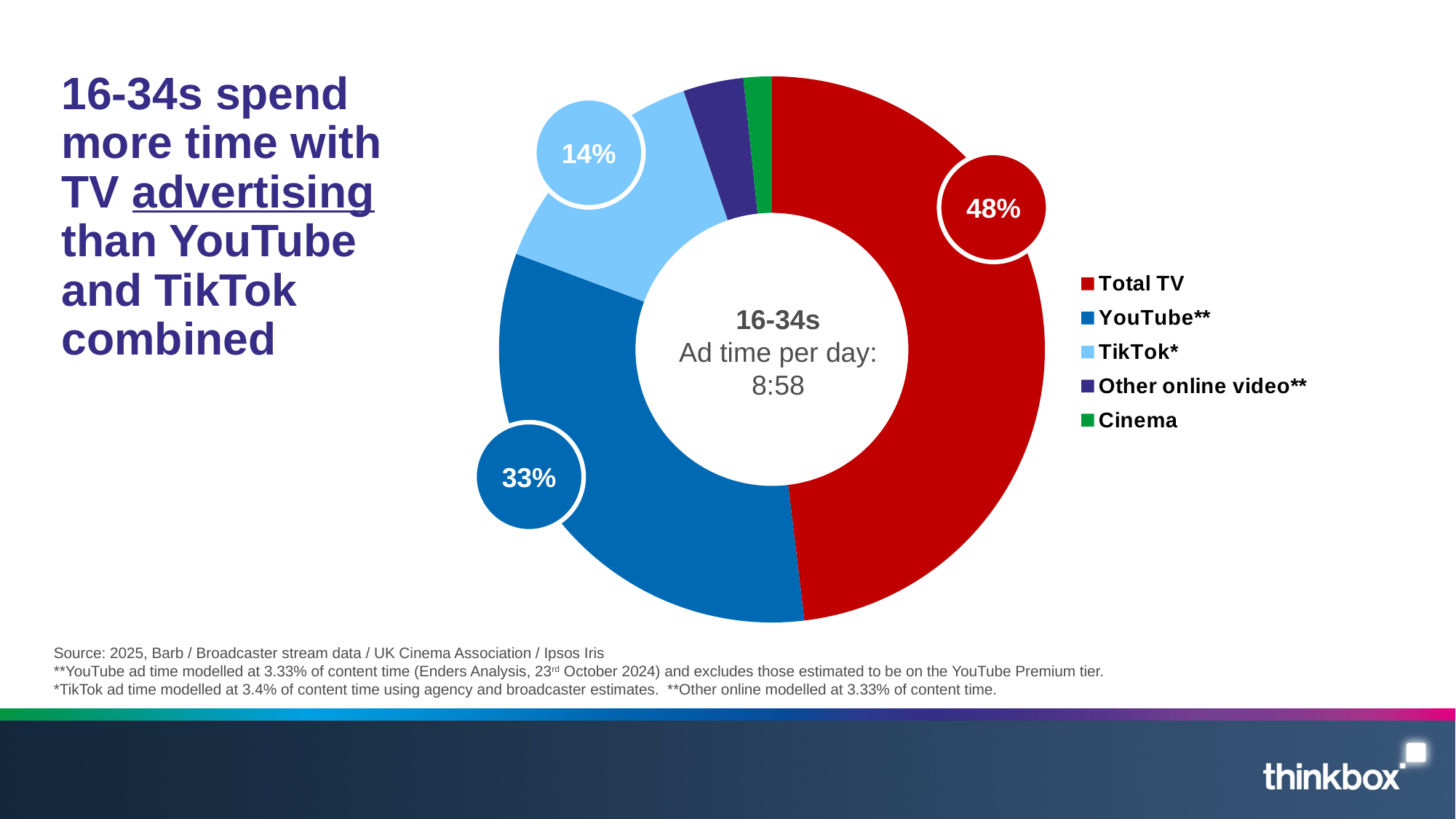
What total ad time per day is shown in the centre of the chart for 16-34s? 8:58 What share of ad time per day for 16-34s does YouTube** account for? 33% How many categories does the legend of the chart list? 5 What is the combined share of YouTube** and TikTok*? 47% Which category has the largest share of the donut chart? Total TV What share of ad time per day for 16-34s does TikTok* account for? 14% What is the difference in percentage points between the Total TV share and the YouTube** share? 15 Which is larger, the share for YouTube** or the share for TikTok*? YouTube** What colour is the Total TV segment of the chart? Red Which category has the smallest share of the donut chart? Cinema What share of ad time per day for 16-34s does Total TV account for? 48% What kind of chart is shown on the slide? Donut (pie) chart